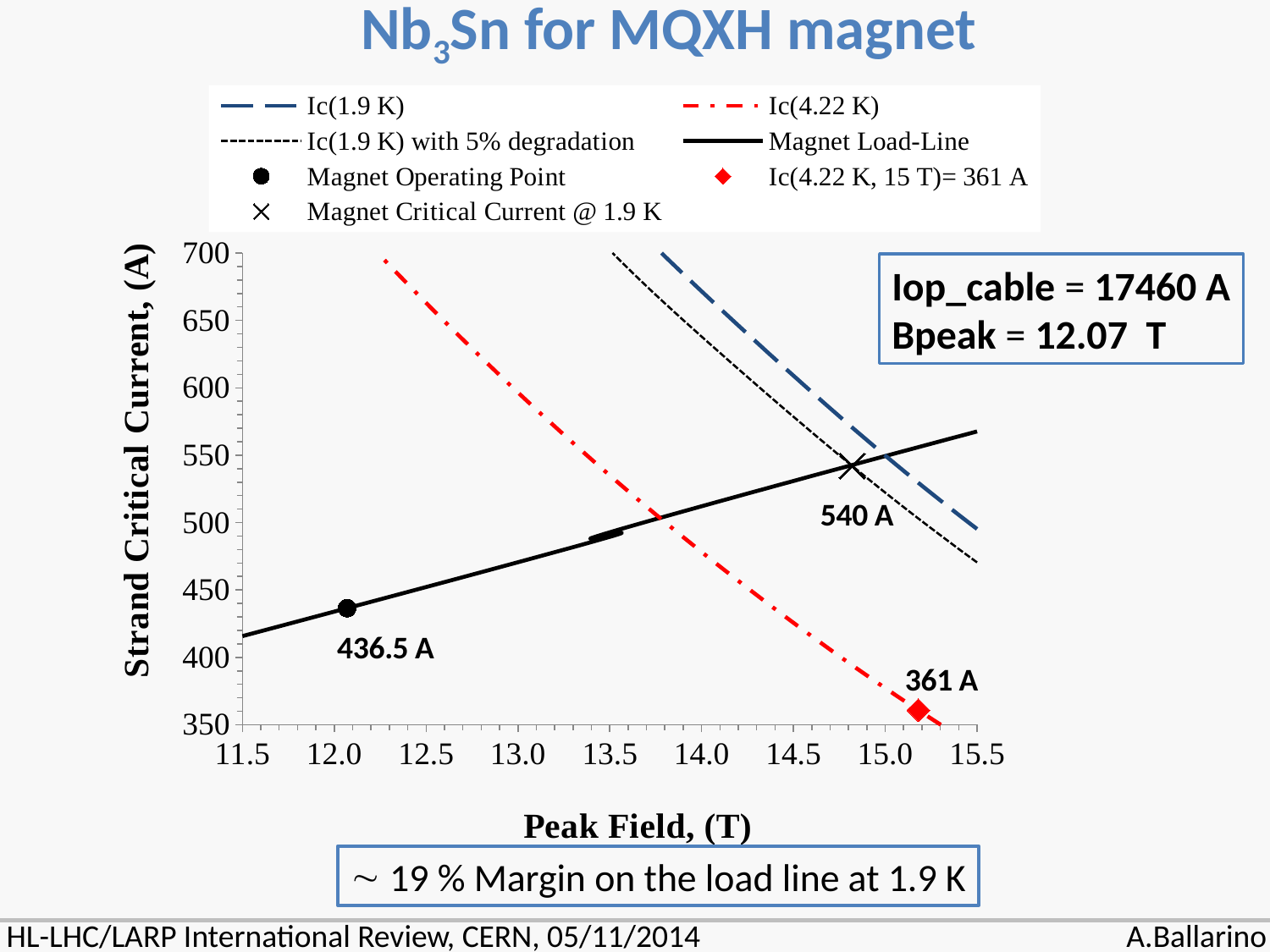
Is the value of the Ic(4.22 K) curve at 13.0 T greater or less than 550? greater What is the value labelled at the Magnet Critical Current @ 1.9 K point? 540 A Does the Ic(4.22 K) curve rise or fall as the peak field increases? fall What is the label of the x axis of the chart? Peak Field, (T) How many entries does the chart legend list? 7 What kind of chart is shown on the slide? line chart What is the difference between the Magnet Operating Point value and the Ic(4.22 K, 15 T) value? 75.5 A Does the Magnet Load-Line rise or fall as the peak field increases? rise What is the difference between the Magnet Critical Current @ 1.9 K (540 A) and the Magnet Operating Point (436.5 A)? 103.5 A Which is larger, the Magnet Operating Point current or the Ic(4.22 K, 15 T) current? Magnet Operating Point What is the strand critical current at the Magnet Operating Point? 436.5 A What is the value of Ic(4.22 K, 15 T) shown on the chart? 361 A